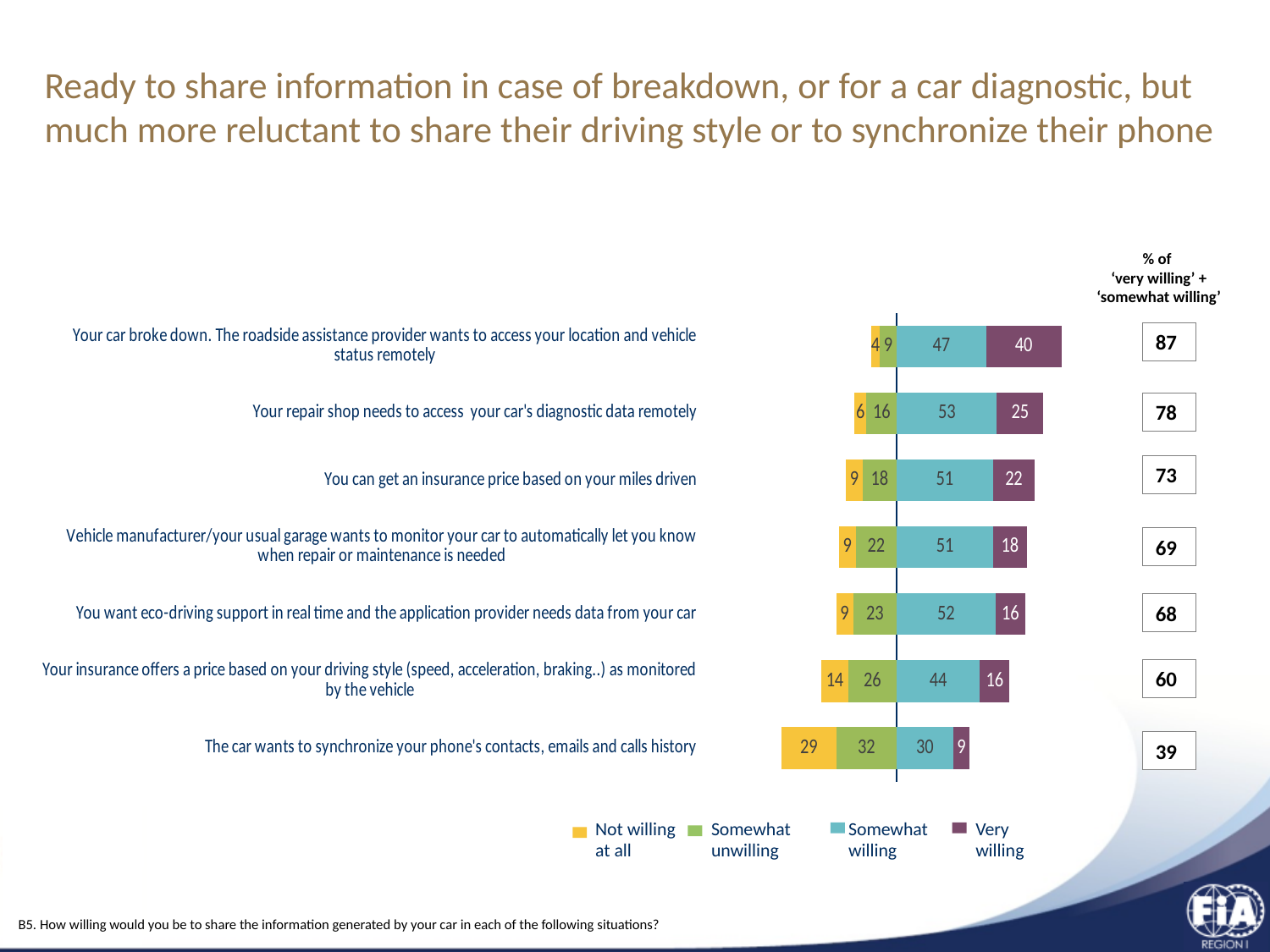
How many situations (categories) are plotted in the chart? 7 Which has a larger 'Very willing' value: 'You can get an insurance price based on your miles driven' or 'You want eco-driving support in real time and the application provider needs data from your car'? You can get an insurance price based on your miles driven Which situation has the lowest '% of very willing + somewhat willing' value? The car wants to synchronize your phone's contacts, emails and calls history How many series does the legend list? 4 Which situation has the highest '% of very willing + somewhat willing' value? Your car broke down. The roadside assistance provider wants to access your location and vehicle status remotely What is the difference between the 'Somewhat unwilling' values for 'The car wants to synchronize your phone's contacts, emails and calls history' and 'Your car broke down. The roadside assistance provider wants to access your location and vehicle status remotely'? 23 What is the 'Not willing at all' value for 'The car wants to synchronize your phone's contacts, emails and calls history'? 29 What is the '% of very willing + somewhat willing' value for 'Your insurance offers a price based on your driving style (speed, acceleration, braking..) as monitored by the vehicle'? 60 What is the 'Very willing' value for 'Your car broke down. The roadside assistance provider wants to access your location and vehicle status remotely'? 40 What kind of chart is shown on the slide? Stacked bar chart Which colour represents the 'Very willing' series in the chart? Purple What is the 'Somewhat willing' value for 'Your repair shop needs to access your car's diagnostic data remotely'? 53